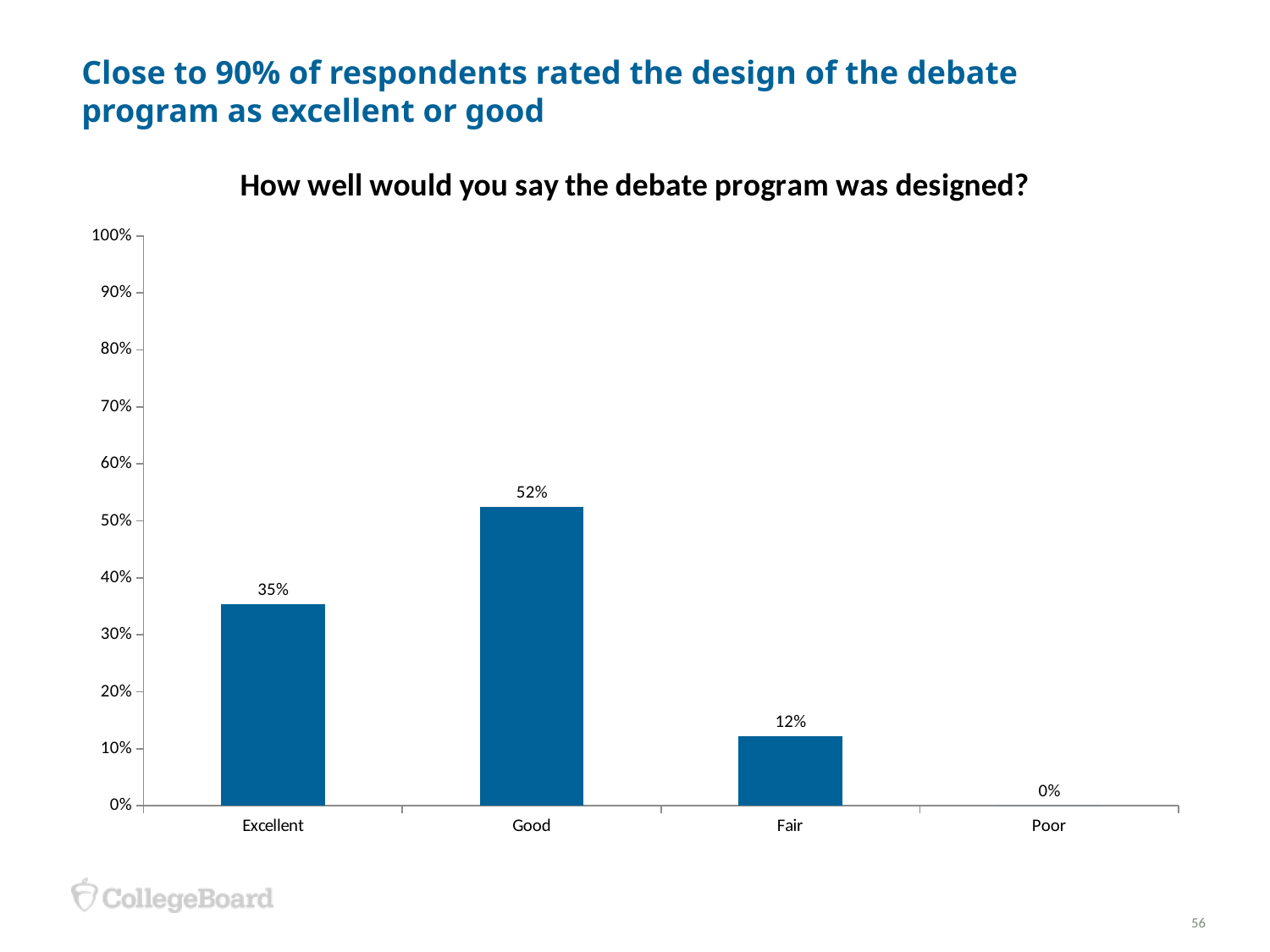
Which rating category has the lowest percentage of respondents? Poor What percentage of respondents rated the debate program's design as Poor? 0% What percentage of respondents rated the debate program's design as Good? 52% How many rating categories are shown on the x axis? 4 What percentage of respondents rated the debate program's design as Excellent? 35% What is the difference in percentage points between the Good and Excellent ratings? 17% Which rating received a larger share of respondents, Excellent or Fair? Excellent What percentage of respondents rated the debate program's design as Fair? 12% What type of chart is shown on the slide? Bar chart Which rating category has the highest percentage of respondents? Good Is the value for Good greater or less than 50%? greater What is the title of the chart? How well would you say the debate program was designed?